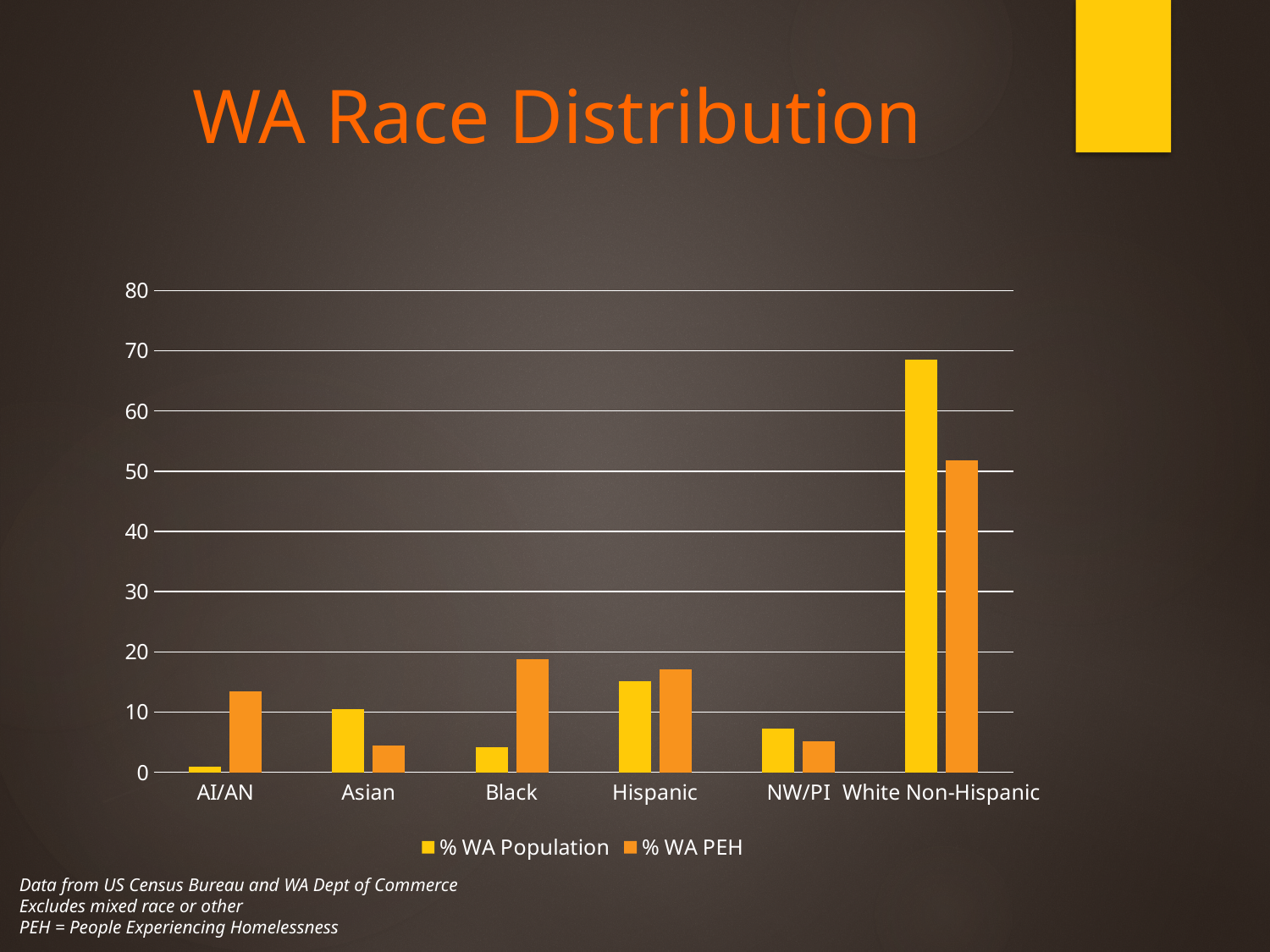
What type of chart is shown on the slide? bar chart For Asian, which is larger: % WA Population or % WA PEH? % WA Population What is the title of the chart? WA Race Distribution Which category has the highest % WA PEH? White Non-Hispanic Is the % WA PEH value for AI/AN greater or less than 10? greater For Black, which is larger: % WA Population or % WA PEH? % WA PEH Which category has the lowest % WA Population? AI/AN Is the % WA Population value for White Non-Hispanic greater or less than 60? greater How many race categories are shown on the x axis? 6 How many series does the legend list? 2 Is the % WA Population value for Black greater or less than 10? less Which category has the highest % WA Population? White Non-Hispanic